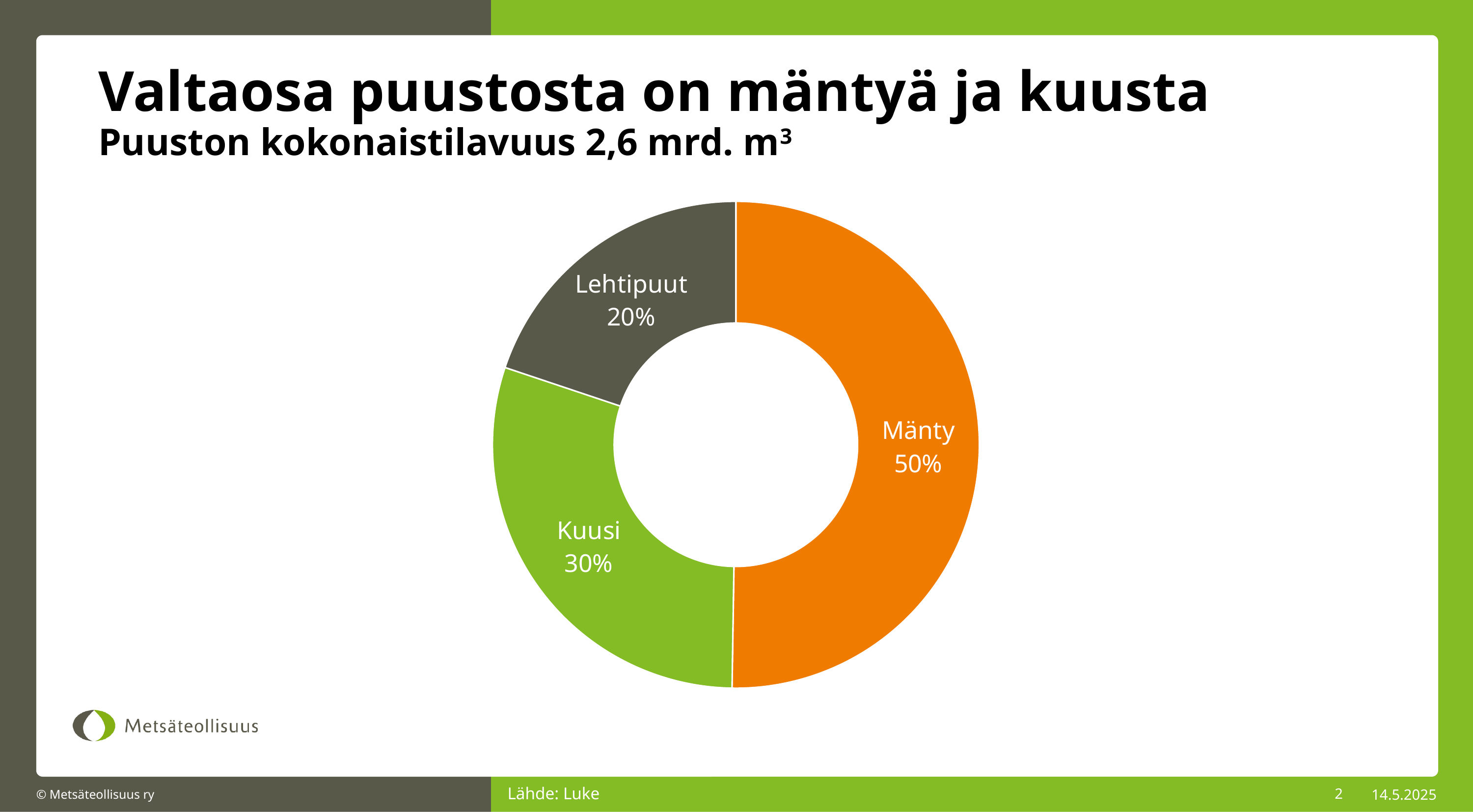
Which category has the smallest share of the chart? Lehtipuut What kind of chart is shown on the slide? Doughnut (pie) chart What is the difference in percentage points between the shares of Mänty and Kuusi? 20 What share of the chart does Mänty account for? 50% What total volume of timber is stated in the slide subtitle? 2,6 mrd. m³ How many categories are shown in the chart? 3 What colour is the Mänty segment of the chart? Orange What share of the chart does Lehtipuut account for? 20% What share of the chart does Kuusi account for? 30% Which category has the largest share of the chart? Mänty Which has a larger share, Kuusi or Lehtipuut? Kuusi What is the difference in percentage points between the shares of Kuusi and Lehtipuut? 10